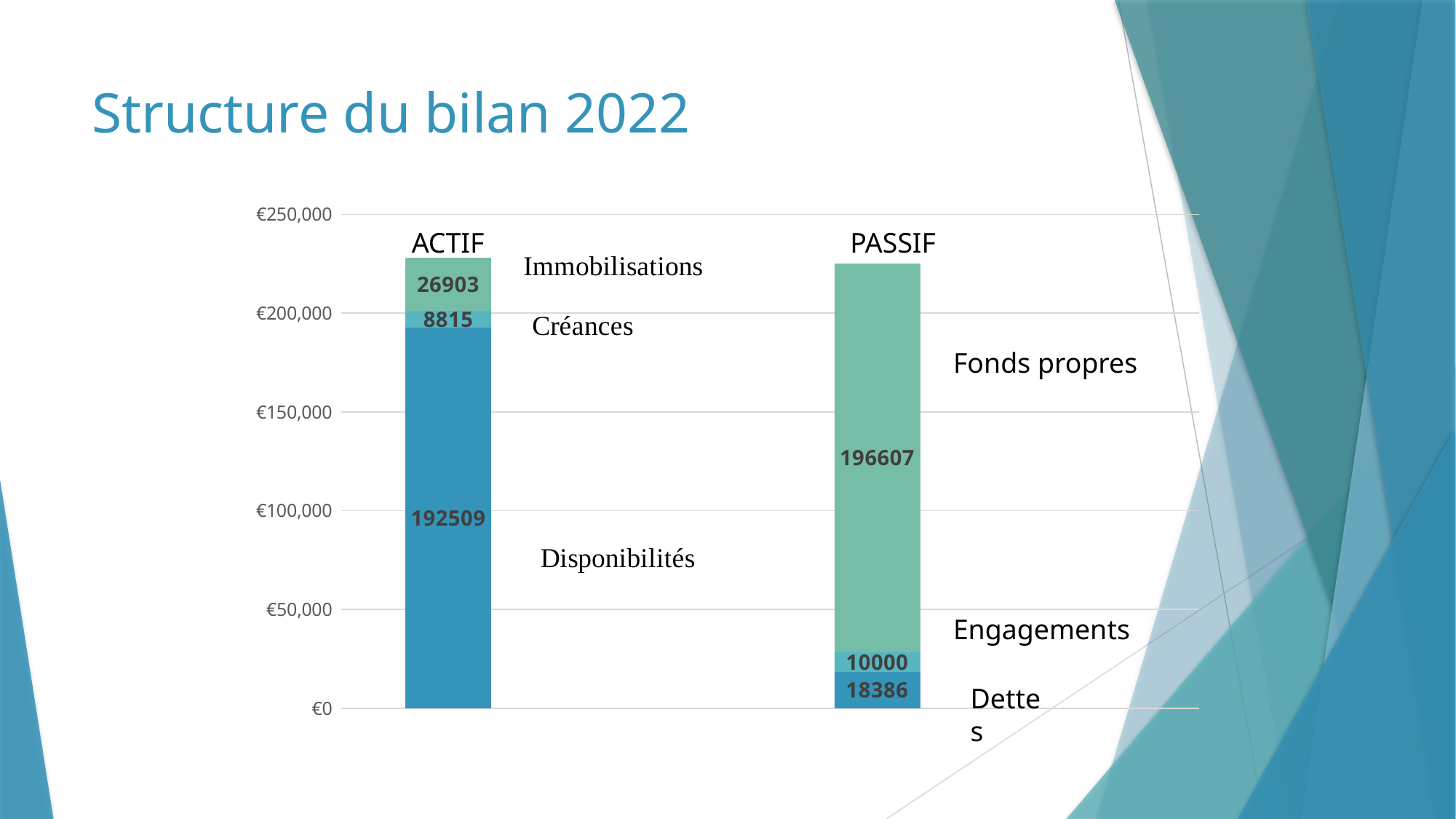
What is the difference between the Fonds propres value and the Disponibilités value? 4098 Which is larger, the Immobilisations segment or the Dettes segment? Immobilisations Which segment of the PASSIF bar is the largest? Fonds propres What is the value of the Dettes segment in the PASSIF bar? 18386 What is the value of the Immobilisations segment in the ACTIF bar? 26903 What is the value of the Engagements segment in the PASSIF bar? 10000 What kind of chart is shown on the slide? Stacked bar chart What is the total of the ACTIF stacked bar? 228227 Which segment of the ACTIF bar is the smallest? Créances What is the value of the Créances segment in the ACTIF bar? 8815 What is the value of the Fonds propres segment in the PASSIF bar? 196607 What is the value of the Disponibilités segment in the ACTIF bar? 192509